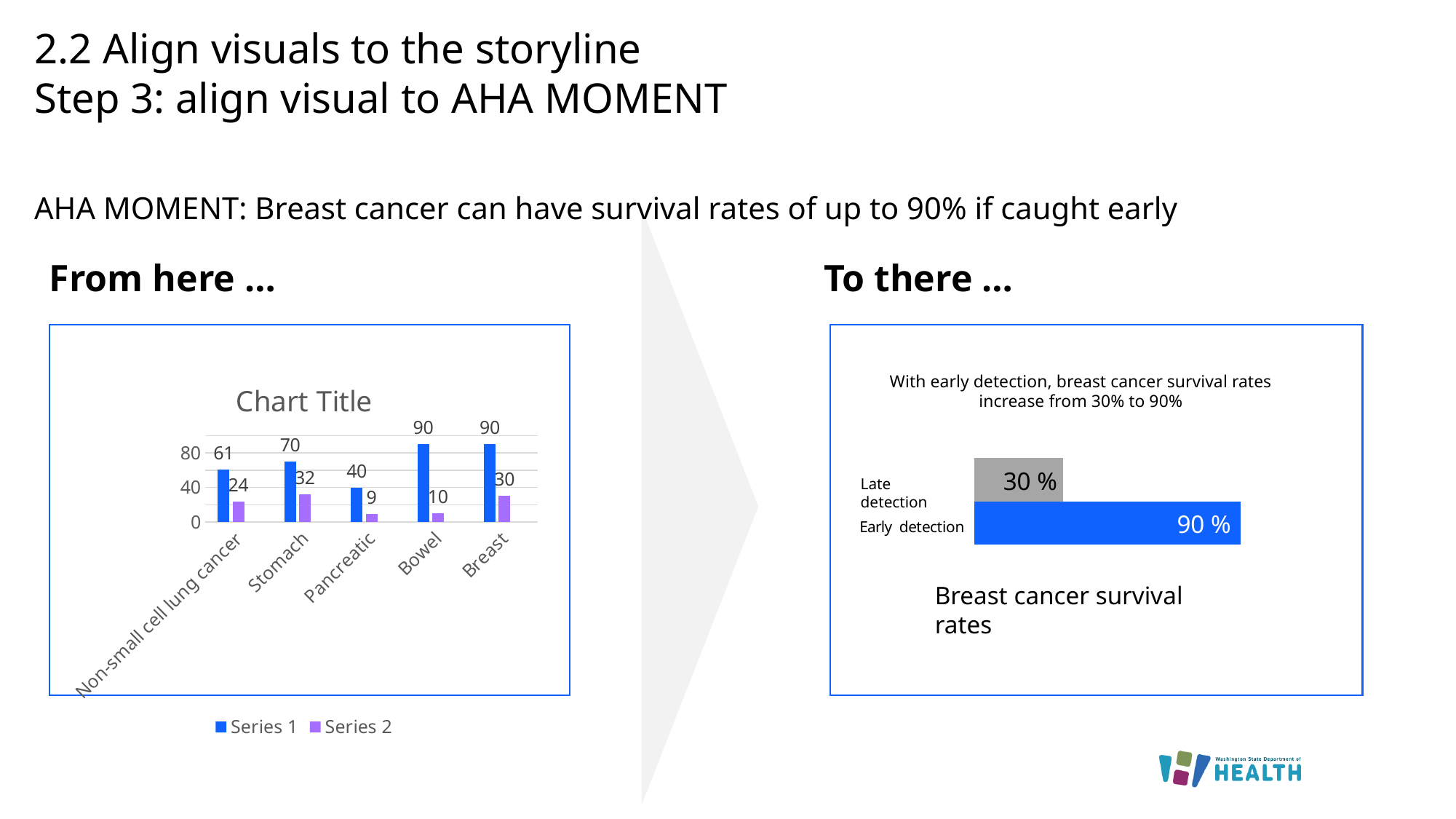
In the left chart titled 'Chart Title', how many series does the legend list? 2 In the left chart titled 'Chart Title', what is the Series 1 value for Stomach? 70 In the left chart titled 'Chart Title', which category has the highest Series 2 value? Stomach In the left chart titled 'Chart Title', what is the Series 2 value for Non-small cell lung cancer? 24 In the left chart titled 'Chart Title', which category has the lowest Series 2 value? Pancreatic In the left chart titled 'Chart Title', what is the difference between the Series 1 and Series 2 values for Breast? 60 What kind of chart is the left chart titled 'Chart Title'? Bar chart In the right chart 'Breast cancer survival rates', what is the value for Late detection? 30 % In the left chart titled 'Chart Title', is the Series 1 value for Stomach or for Pancreatic larger? Stomach In the left chart titled 'Chart Title', how many categories are shown on the x axis? 5 In the right chart 'Breast cancer survival rates', what is the difference between the Early detection and Late detection values? 60 % In the left chart titled 'Chart Title', what is the Series 2 value for Pancreatic? 9